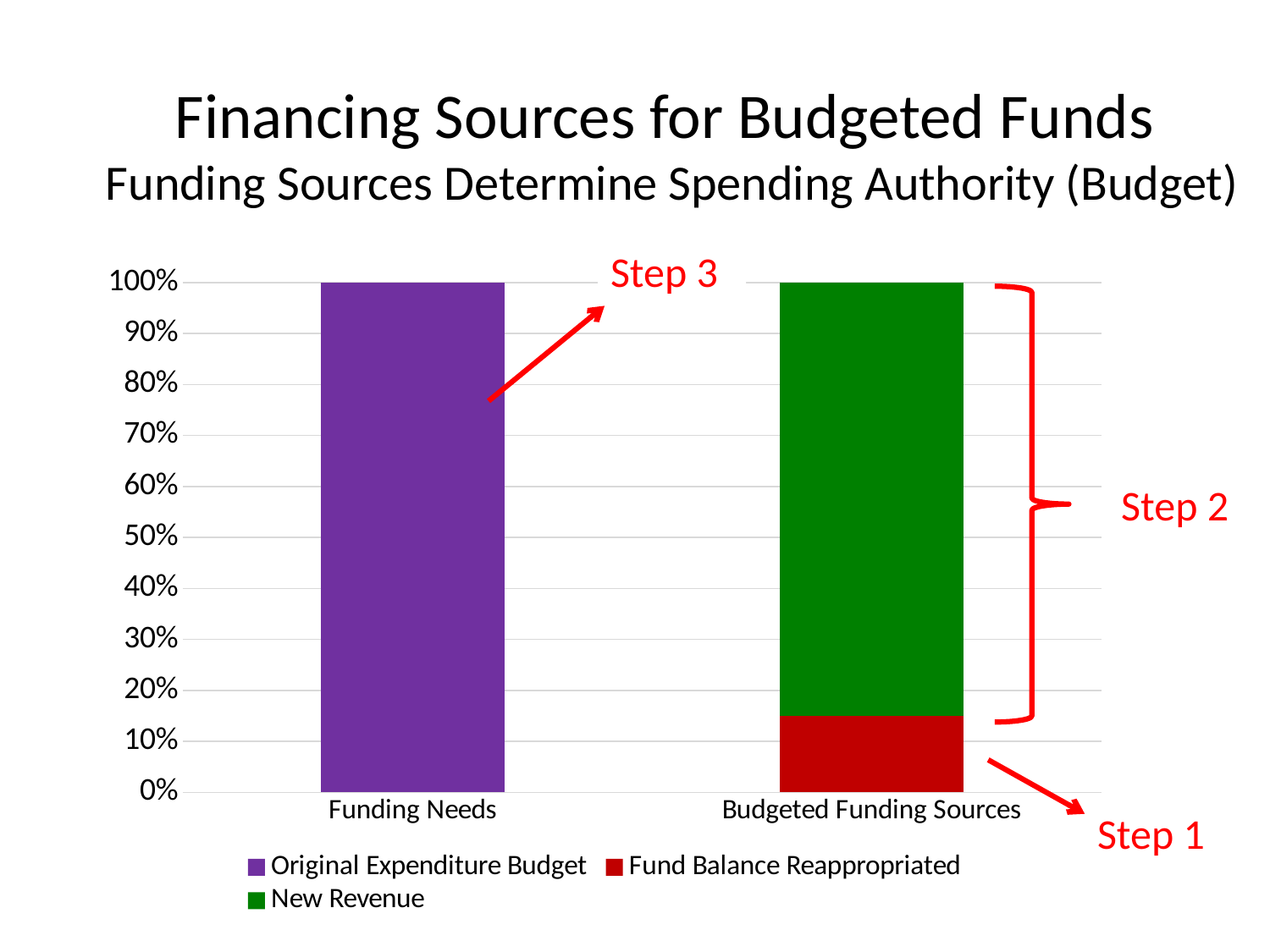
What is the value of the Original Expenditure Budget bar for Funding Needs? 100% How many categories are shown on the x axis of the chart? 2 Is the New Revenue segment for Budgeted Funding Sources greater or less than 80%? greater Which series is shown in green in the chart? New Revenue Within the Budgeted Funding Sources bar, which segment is larger: New Revenue or Fund Balance Reappropriated? New Revenue Is the Fund Balance Reappropriated value for Budgeted Funding Sources greater or less than 20%? less How many series does the chart's legend list? 3 Which series is shown in purple in the chart? Original Expenditure Budget Which category's bar contains the Fund Balance Reappropriated segment? Budgeted Funding Sources What is the total height of the stacked bar for Budgeted Funding Sources? 100% What kind of chart is shown on the slide? Stacked bar chart Is the Fund Balance Reappropriated value for Budgeted Funding Sources greater or less than 10%? greater